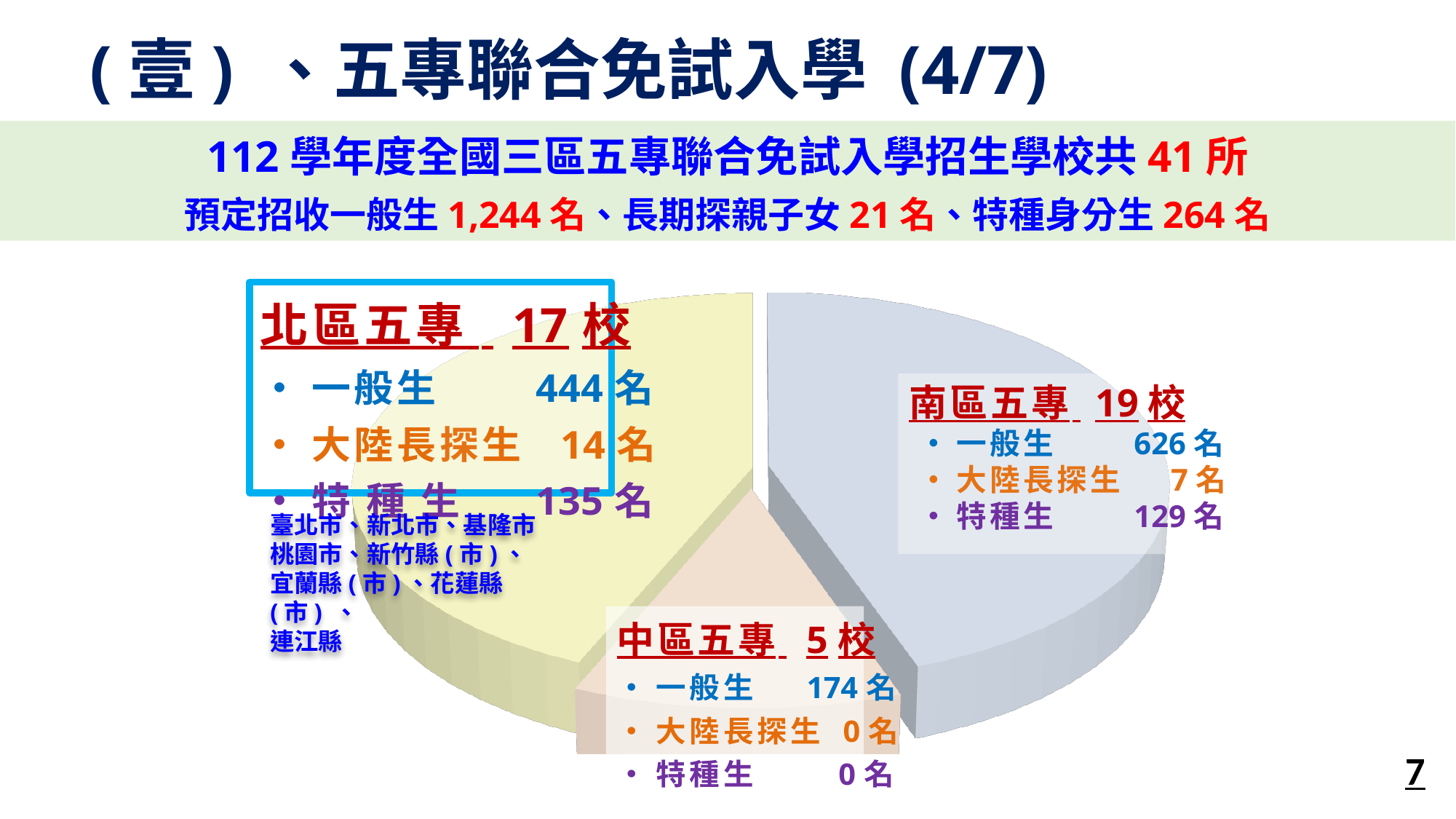
What is the difference in 一般生 between 南區五專 and 北區五專? 182 名 How many slices does the pie chart have? 3 Which has more 特種生, 北區五專 or 南區五專? 北區五專 What colour is the 北區五專 slice of the pie chart? yellow What kind of chart is shown on the slide? pie chart Which region has the largest number of 一般生? 南區五專 How many 特種生 are listed for 南區五專? 129 名 How many schools (校) are listed for 南區五專? 19 校 Which region has the fewest schools (校)? 中區五專 How many 大陸長探生 are listed for 北區五專? 14 名 How many schools (校) are listed for 北區五專? 17 校 How many 一般生 are listed for 中區五專? 174 名